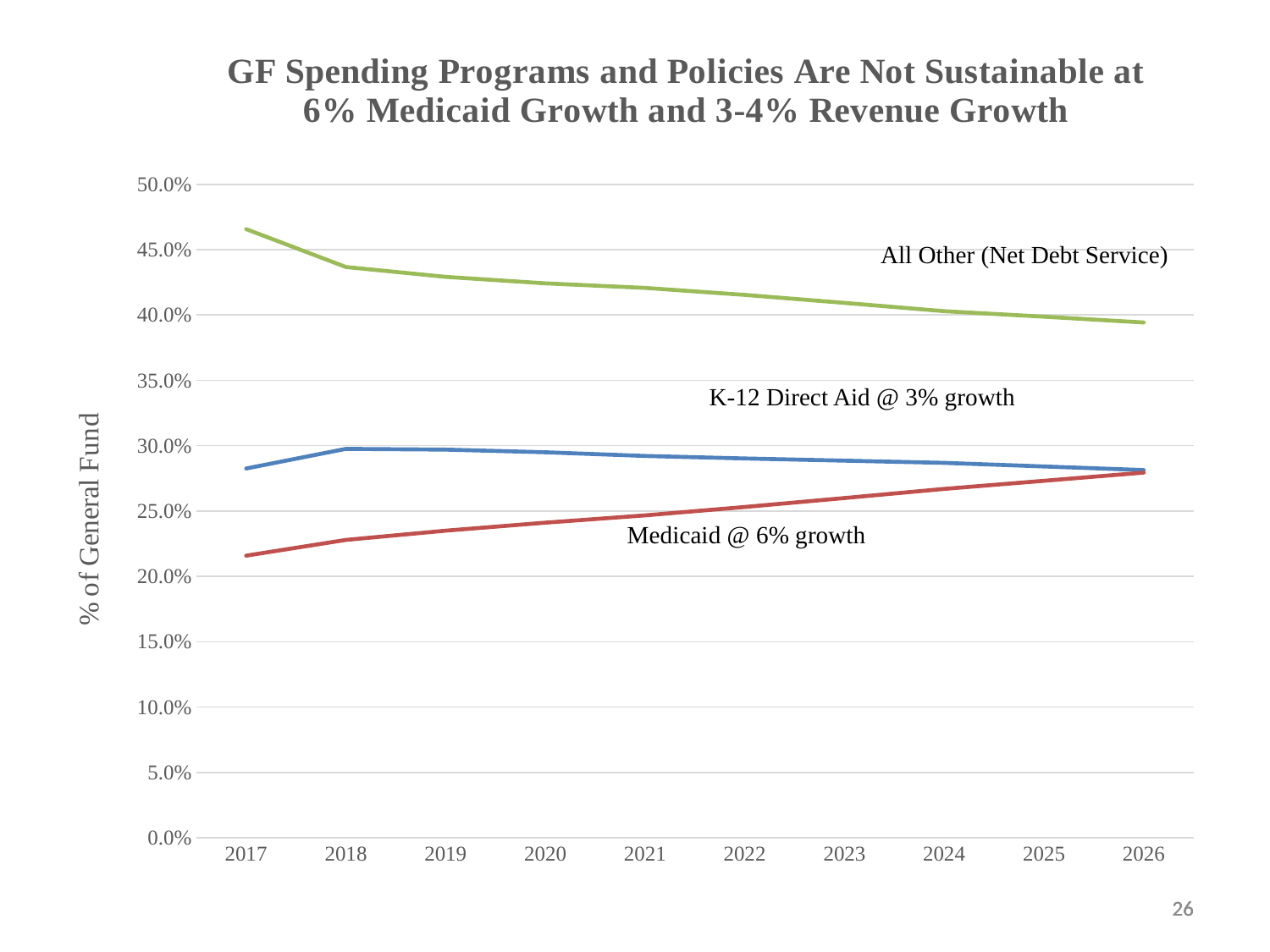
Does the All Other (Net Debt Service) line rise or fall from 2017 to 2026? fall How many lines (series) are plotted on the chart? 3 What is the label on the vertical axis of the chart? % of General Fund In 2017, which is larger: K-12 Direct Aid @ 3% growth or Medicaid @ 6% growth? K-12 Direct Aid @ 3% growth Does the Medicaid @ 6% growth line rise or fall from 2017 to 2026? rise Is the value for Medicaid @ 6% growth in 2017 greater or less than 25.0%? less Is the value for All Other (Net Debt Service) in 2017 greater or less than 45.0%? greater Which series has the highest share of the General Fund across all years shown? All Other (Net Debt Service) How many years are shown along the x axis of the chart? 10 What kind of chart is shown on the slide? line chart Is the value for Medicaid @ 6% growth in 2026 greater or less than 25.0%? greater